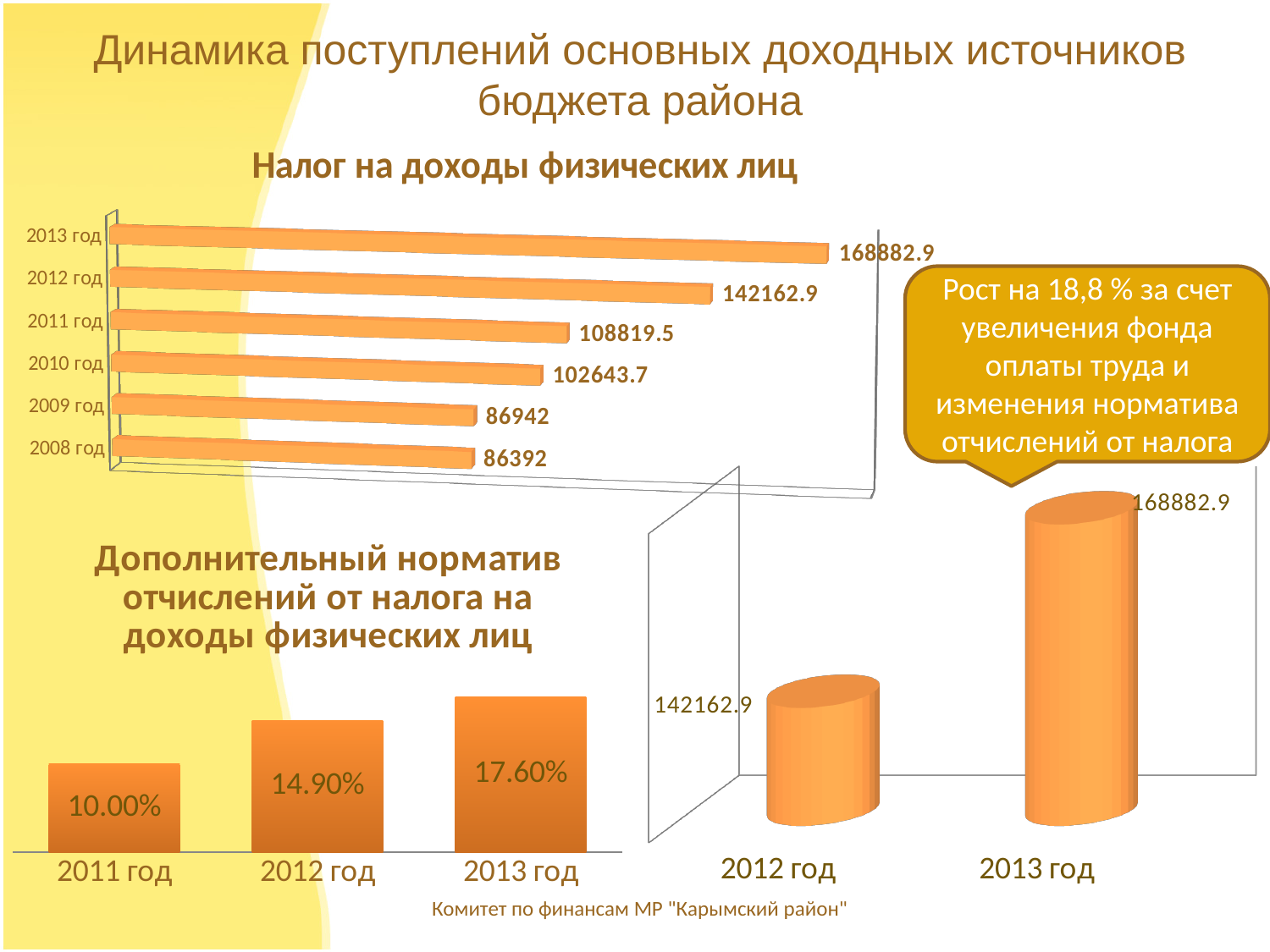
In the cylinder chart at the bottom right of the slide, what is the value for 2012 год? 142162.9 In the chart titled "Дополнительный норматив отчислений от налога на доходы физических лиц", what is the value for 2012 год? 14.90% In the chart titled "Налог на доходы физических лиц", what is the value for 2013 год? 168882.9 In the chart titled "Дополнительный норматив отчислений от налога на доходы физических лиц", what is the difference between the values for 2013 год and 2011 год? 7.60% In the chart titled "Дополнительный норматив отчислений от налога на доходы физических лиц", do the values rise or fall from 2011 год to 2013 год? rise In the chart titled "Налог на доходы физических лиц", what is the difference between the values for 2013 год and 2012 год? 26720 In the chart titled "Налог на доходы физических лиц", what is the value for 2010 год? 102643.7 In the chart titled "Налог на доходы физических лиц", which year has the lowest value? 2008 год In the chart titled "Налог на доходы физических лиц", how many years are shown? 6 In the chart titled "Налог на доходы физических лиц", which year has the highest value? 2013 год What kind of chart is the one titled "Налог на доходы физических лиц"? bar chart In the cylinder chart at the bottom right of the slide, which year has the larger value, 2012 год or 2013 год? 2013 год